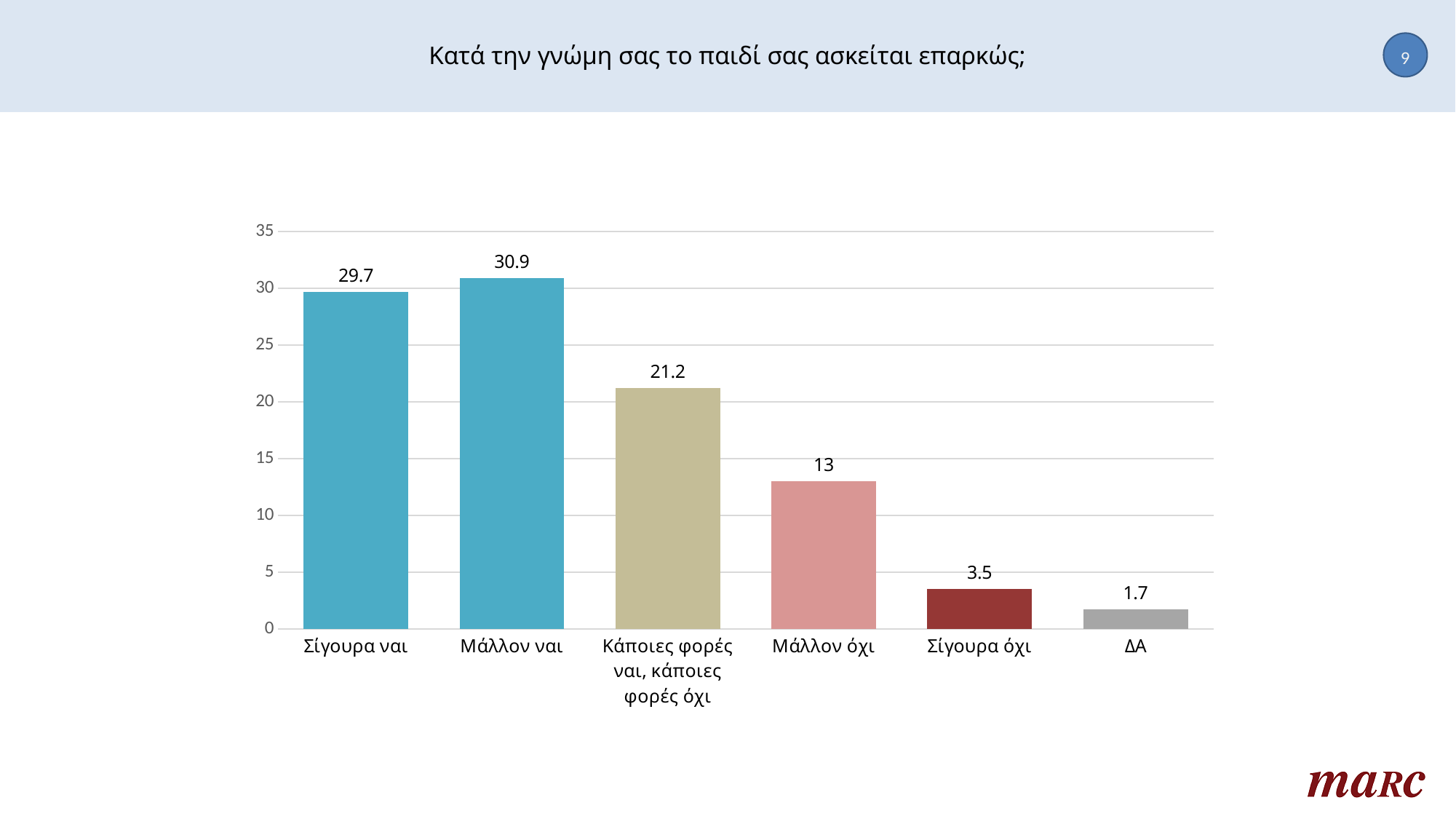
What is the difference between the values for Μάλλον ναι and Σίγουρα ναι? 1.2 Which category has the lowest value? ΔΑ What is the value for Μάλλον όχι? 13 What is the value for Μάλλον ναι? 30.9 What is the difference between the values for Μάλλον όχι and Σίγουρα όχι? 9.5 Which category has the highest value? Μάλλον ναι What is the value for ΔΑ? 1.7 What is the value for Σίγουρα ναι? 29.7 Which is larger, the value for Κάποιες φορές ναι, κάποιες φορές όχι or the value for Μάλλον όχι? Κάποιες φορές ναι, κάποιες φορές όχι What is the value for Κάποιες φορές ναι, κάποιες φορές όχι? 21.2 How many categories are shown on the x axis? 6 What kind of chart is shown on the slide? Bar chart